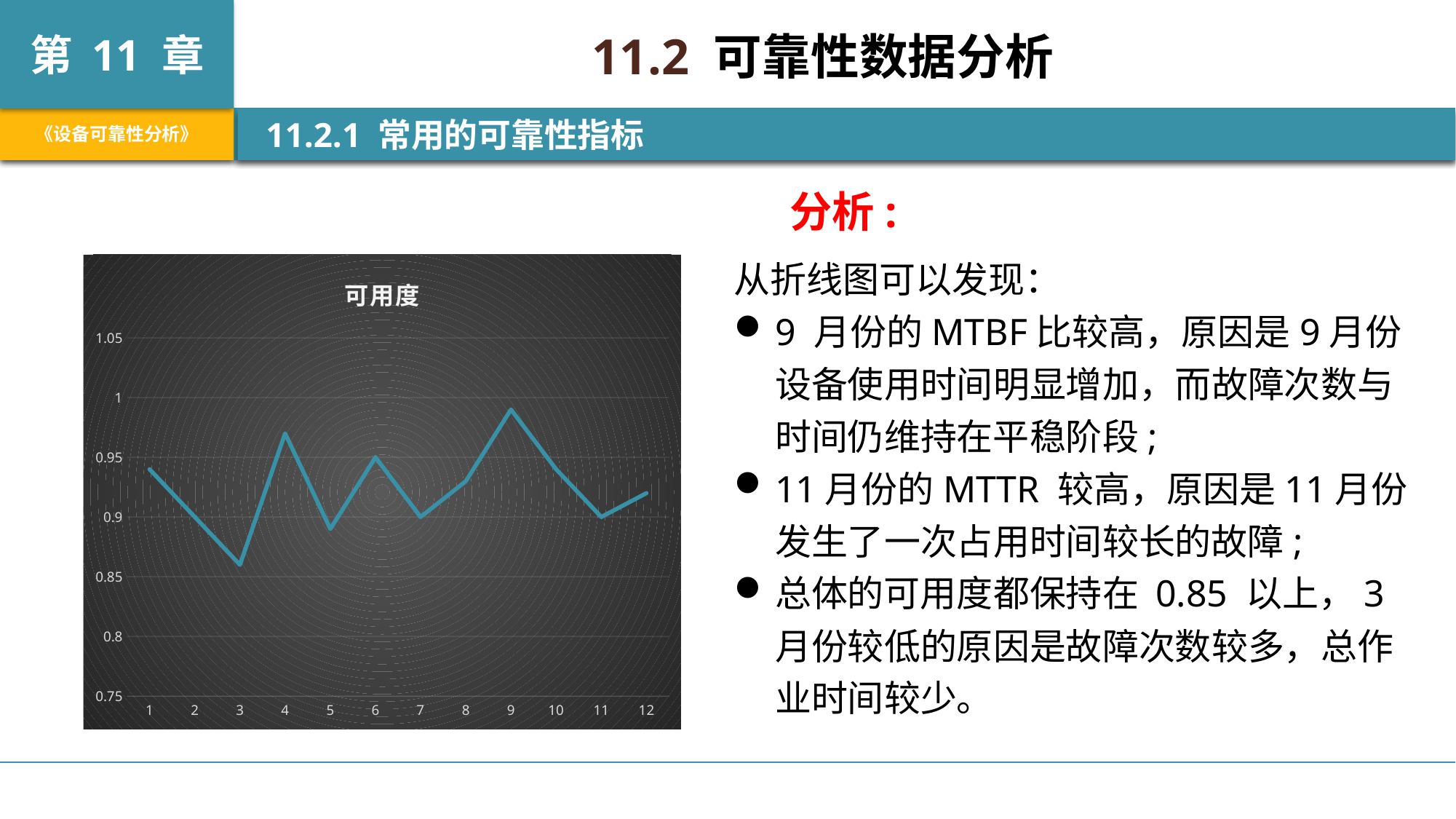
What kind of chart is shown on the slide? line chart Which x-axis category has the highest value in the chart? 9 How many points are plotted along the x axis of the chart? 12 Is the value for category 9 greater or less than 0.95? greater Do the values rise or fall from category 9 to category 11? fall Which has the larger value, category 4 or category 5? 4 Is the value for category 3 greater or less than 0.9? less Which x-axis category has the lowest value in the chart? 3 Which has the larger value, category 9 or category 11? 9 Is the value for category 5 greater or less than 0.9? less What is the title of the chart? 可用度